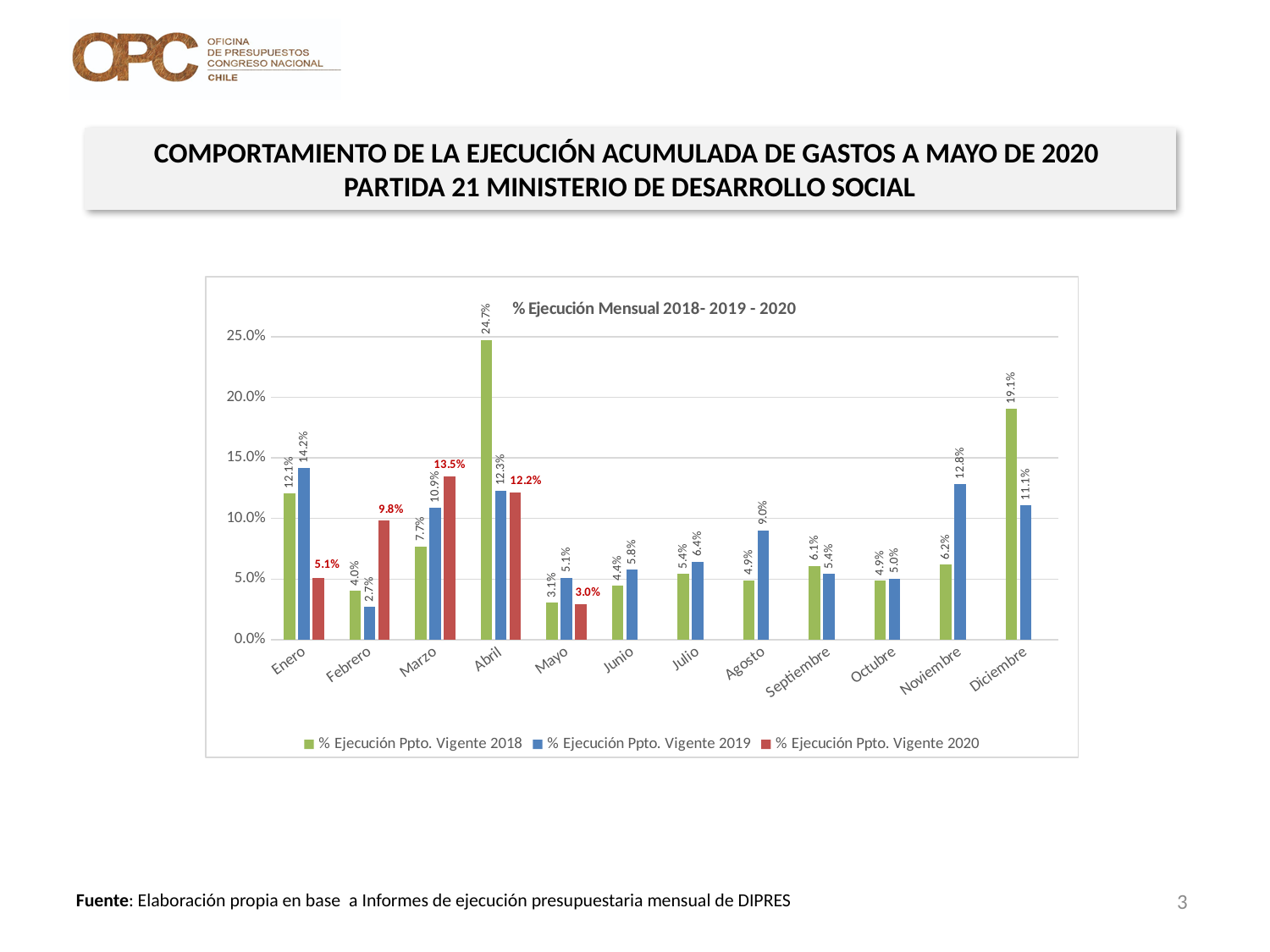
What is the title of the chart? % Ejecución Mensual 2018- 2019 - 2020 What is the value of % Ejecución Ppto. Vigente 2019 for Noviembre? 12.8% What is the value of % Ejecución Ppto. Vigente 2020 for Marzo? 13.5% Which colour represents % Ejecución Ppto. Vigente 2020? red How many months are shown on the x axis? 12 What is the difference between the 2018 and 2019 values for Diciembre? 8.0% Which month has the lowest value for % Ejecución Ppto. Vigente 2019? Febrero How many series does the legend list? 3 What is the value of % Ejecución Ppto. Vigente 2018 for Abril? 24.7% What type of chart is shown on the slide? bar chart Which is larger for Enero: the 2018 value or the 2019 value? 2019 value (14.2%) Which month has the highest value for % Ejecución Ppto. Vigente 2018? Abril